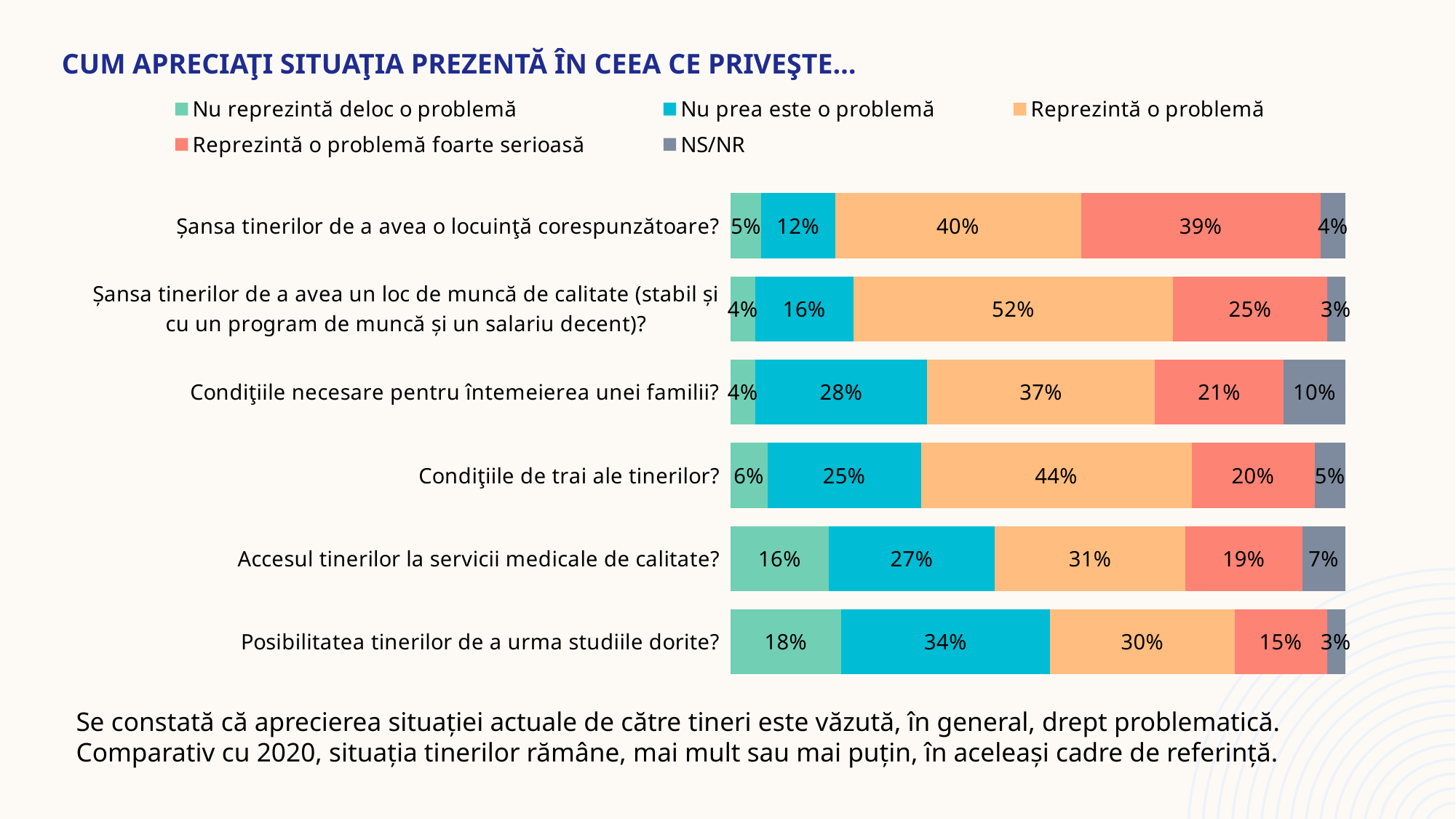
How many categories (questions) are plotted in the chart? 6 What is the total of the stacked bar for "Accesul tinerilor la servicii medicale de calitate?"? 100% What is the value of "Reprezintă o problemă foarte serioasă" for "Șansa tinerilor de a avea o locuinţă corespunzătoare?"? 39% Which category has the highest value for "Nu reprezintă deloc o problemă"? Posibilitatea tinerilor de a urma studiile dorite? Which is larger: the "Nu prea este o problemă" value for "Posibilitatea tinerilor de a urma studiile dorite?" or for "Condiţiile necesare pentru întemeierea unei familii?"? Posibilitatea tinerilor de a urma studiile dorite? Which legend entry is shown in grey? NS/NR What kind of chart is shown on the slide? Stacked bar chart Which category has the lowest value for "Reprezintă o problemă foarte serioasă"? Posibilitatea tinerilor de a urma studiile dorite? What is the difference between the "Reprezintă o problemă" values for "Condiţiile de trai ale tinerilor?" and "Accesul tinerilor la servicii medicale de calitate?"? 13% How many series does the legend list? 5 What is the NS/NR value for "Condiţiile necesare pentru întemeierea unei familii?"? 10% What is the value of "Reprezintă o problemă" for "Șansa tinerilor de a avea un loc de muncă de calitate (stabil și cu un program de muncă și un salariu decent)?"? 52%